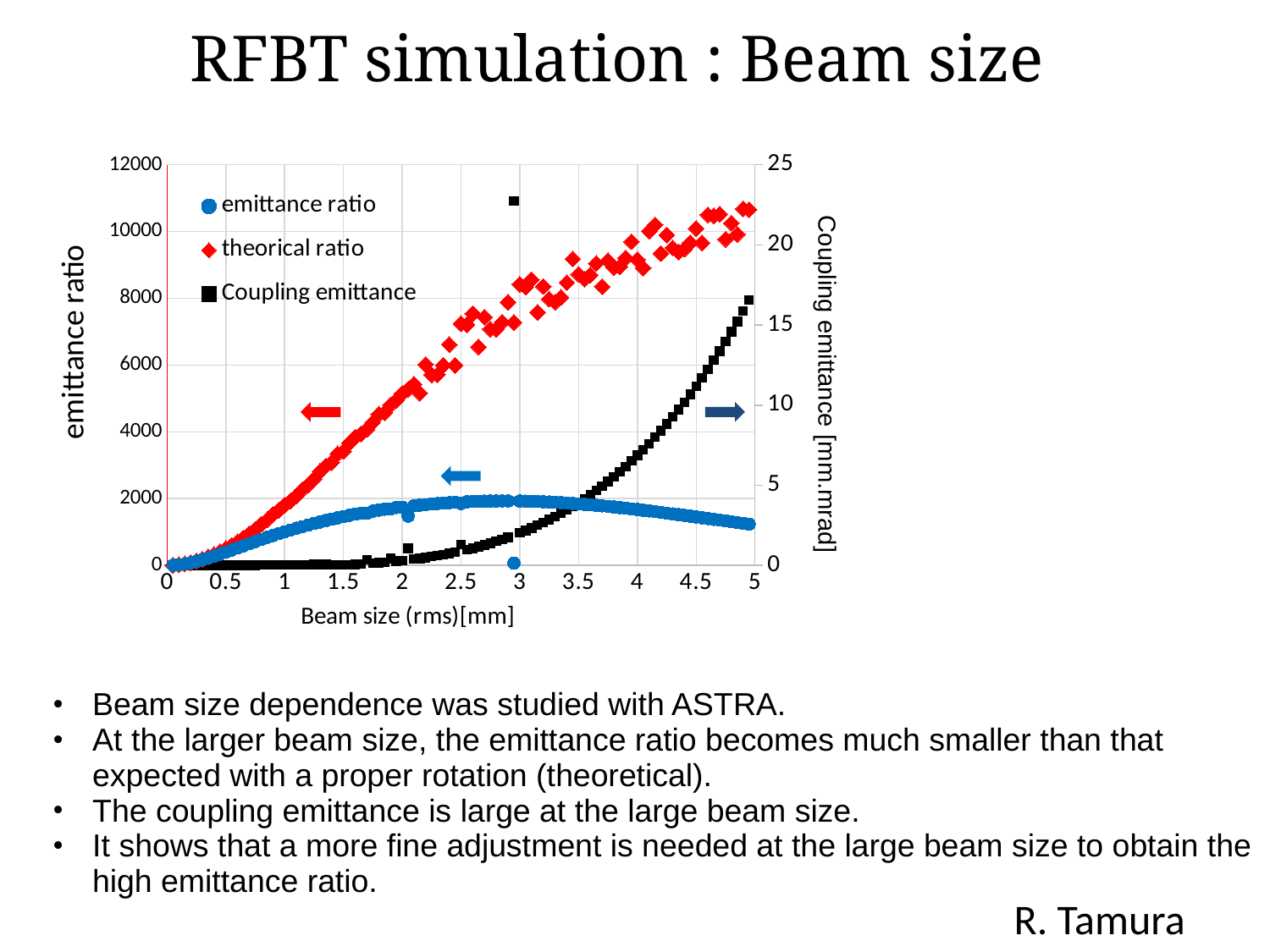
Is the theorical ratio at a beam size of 5 greater or less than 10000? greater How many series does the legend list? 3 Is the Coupling emittance at a beam size of 2 greater or less than 5 on the right axis? less What kind of chart is shown on the slide? scatter chart Does the theorical ratio rise or fall as beam size increases? rise What is the title of the right-hand vertical axis? Coupling emittance [mm.mrad] Does the emittance ratio rise or fall as beam size increases from 3 to 5? fall What is the title of the x axis? Beam size (rms)[mm] Is the Coupling emittance at a beam size of 5 greater or less than 15 on the right axis? greater At a beam size of 4, which is larger: the theorical ratio or the emittance ratio? theorical ratio Does the Coupling emittance rise or fall as beam size increases from 3 to 5? rise